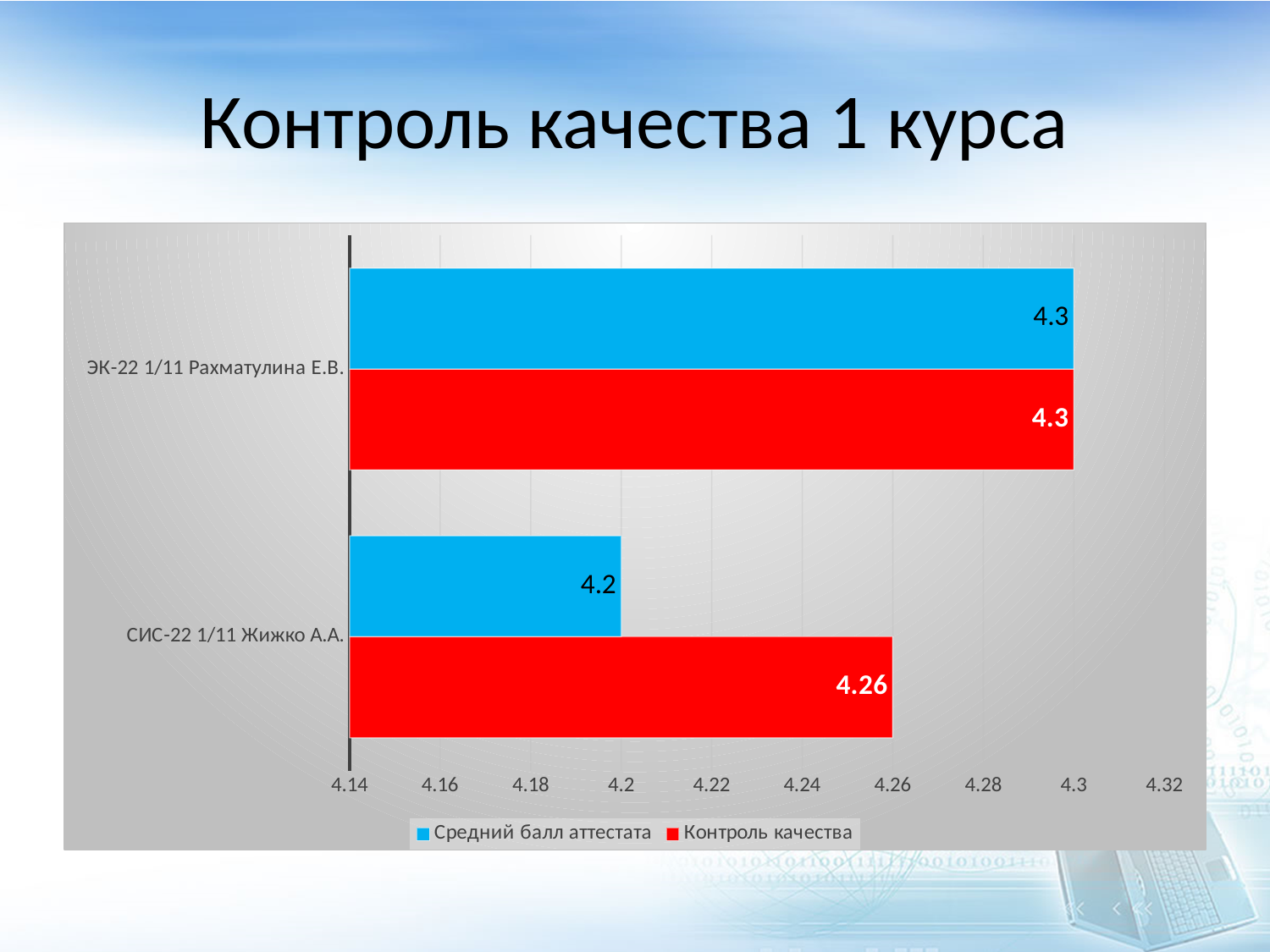
What kind of chart is shown on the slide? Bar chart Which category has the highest Контроль качества value? ЭК-22 1/11 Рахматулина Е.В. What is the difference between the Контроль качества values for ЭК-22 1/11 Рахматулина Е.В. and СИС-22 1/11 Жижко А.А.? 0.04 How many categories are shown on the chart? 2 Which category has the lowest Средний балл аттестата value? СИС-22 1/11 Жижко А.А. What is the value of Средний балл аттестата for ЭК-22 1/11 Рахматулина Е.В.? 4.3 For СИС-22 1/11 Жижко А.А., which is larger: Средний балл аттестата or Контроль качества? Контроль качества How many series does the legend list? 2 What is the value of Средний балл аттестата for СИС-22 1/11 Жижко А.А.? 4.2 What is the value of Контроль качества for СИС-22 1/11 Жижко А.А.? 4.26 What is the value of Контроль качества for ЭК-22 1/11 Рахматулина Е.В.? 4.3 What is the title of the slide? Контроль качества 1 курса